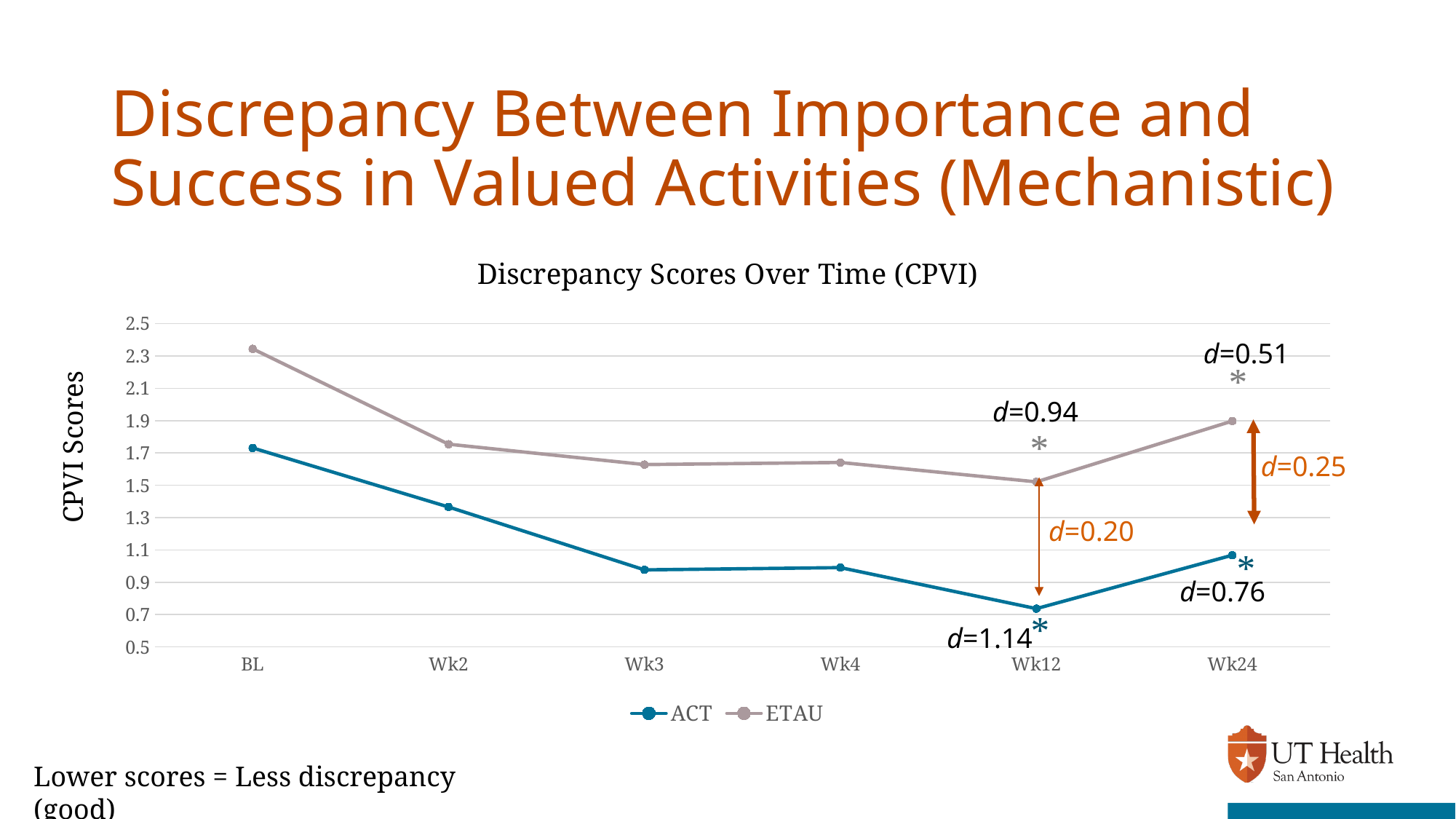
Is the ETAU value at BL greater or less than 2.1? greater At BL, which series has the higher CPVI score, ACT or ETAU? ETAU At which time point does the ACT series reach its lowest value? Wk12 At which time point does the ETAU series reach its lowest value? Wk12 At which time point does the ETAU series reach its highest value? BL What is the title of the chart? Discrepancy Scores Over Time (CPVI) How many series does the legend list? 2 How many time points are plotted along the x axis? 6 Is the ACT value at BL greater or less than 1.5? greater Does the ACT series rise or fall from BL to Wk12? fall What kind of chart is shown on the slide? Line chart Is the ACT value at Wk12 greater or less than 0.9? less